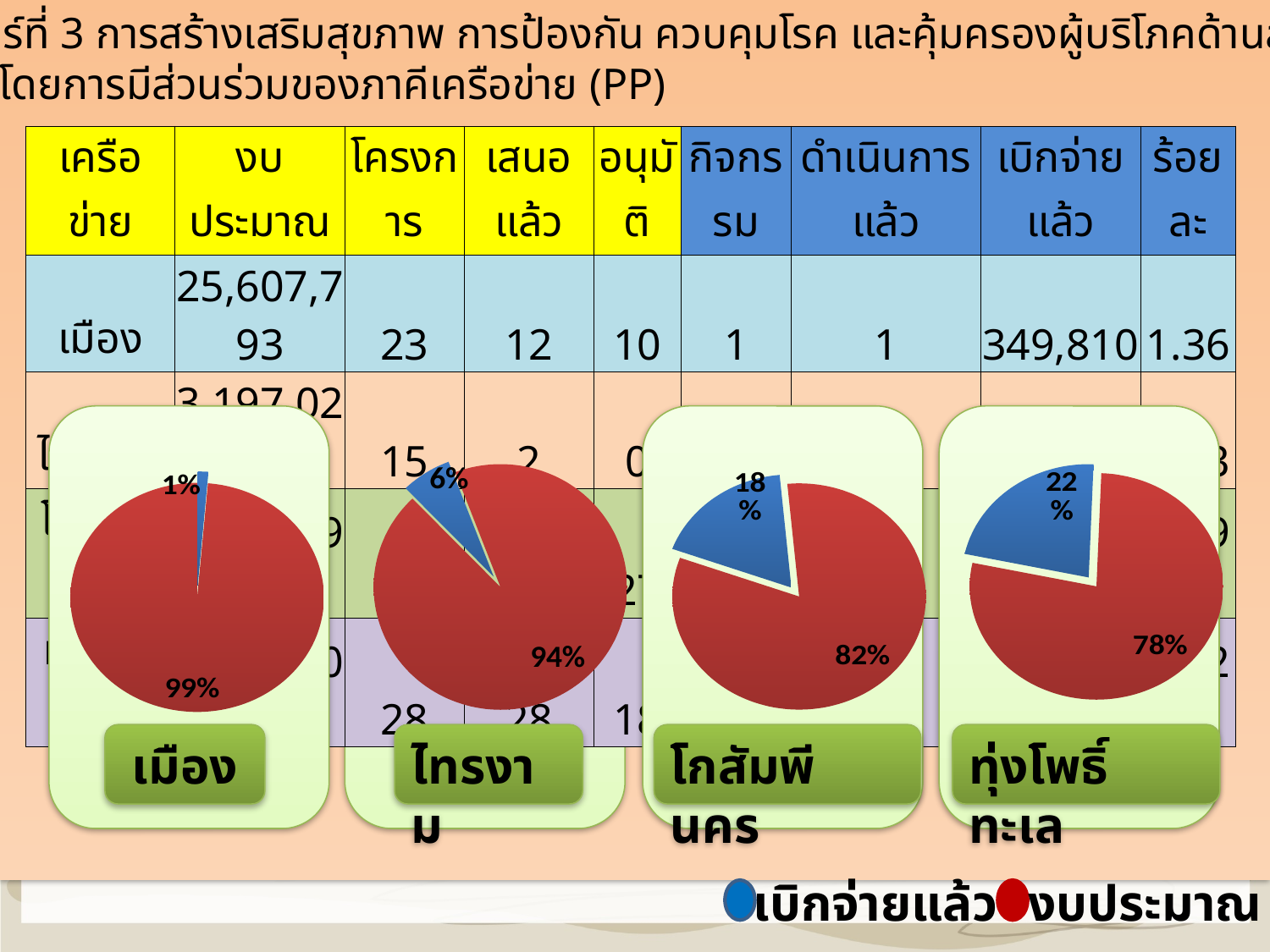
What type of chart is used for the four charts on the slide? Pie chart In the pie chart labelled เมือง, what share is shown for งบประมาณ (the red slice)? 99% In the pie chart labelled เมือง, what share is shown for เบิกจ่ายแล้ว (the blue slice)? 1% Is the เบิกจ่ายแล้ว share larger in the ไทรงาม pie chart or in the โกสัมพีนคร pie chart? โกสัมพีนคร How many series does the legend at the bottom of the slide list? 2 In the pie chart labelled ไทรงาม, what share is shown for งบประมาณ (the red slice)? 94% Which of the four pie charts shows the smallest share for เบิกจ่ายแล้ว (the blue slice)? เมือง In the pie chart labelled โกสัมพีนคร, what is the difference between the งบประมาณ share and the เบิกจ่ายแล้ว share? 64% Which of the four pie charts shows the largest share for เบิกจ่ายแล้ว (the blue slice)? ทุ่งโพธิ์ทะเล